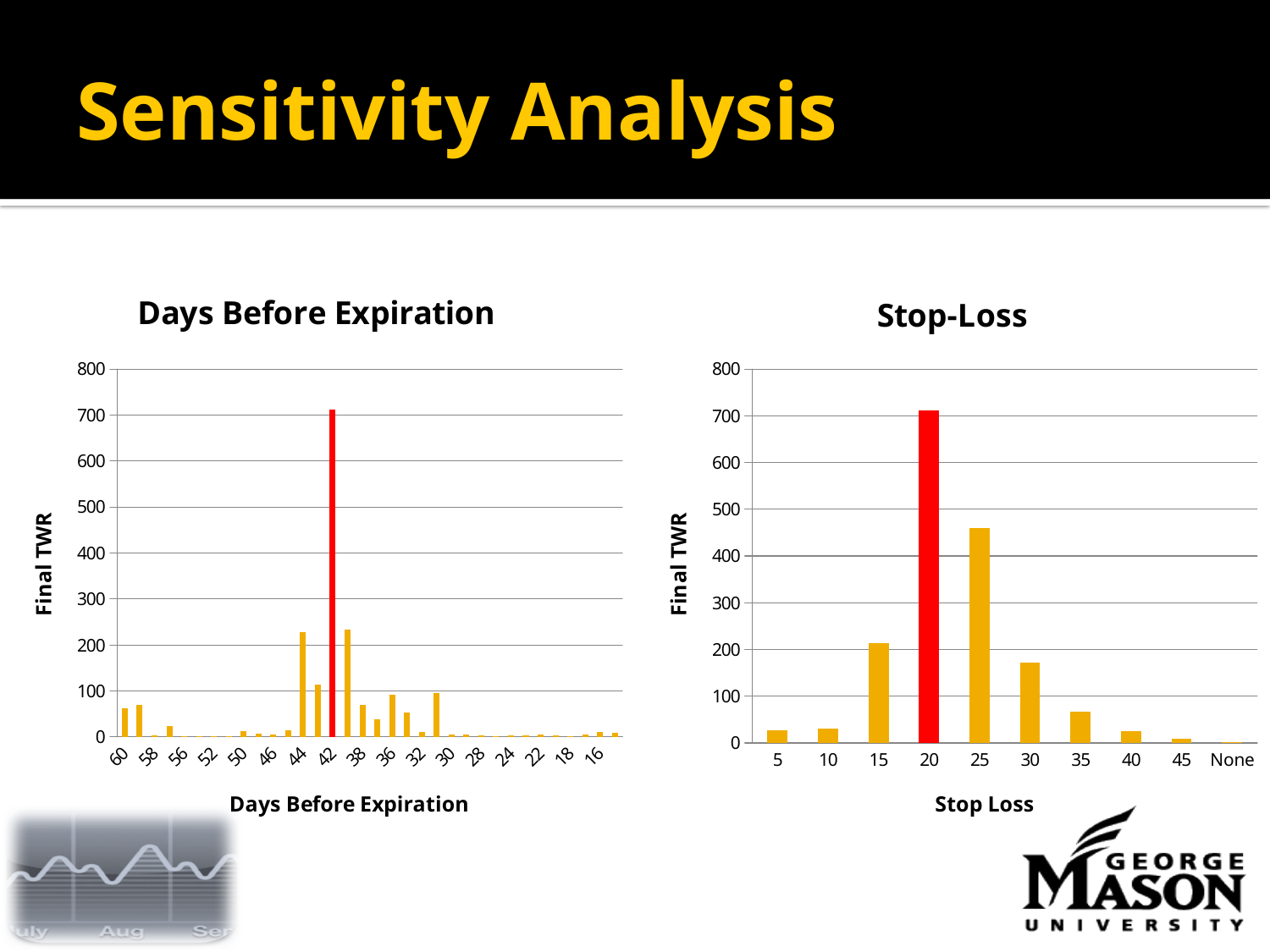
In the Stop-Loss chart, is the Final TWR for a stop loss of 25 greater or less than 500? less In the Stop-Loss chart, which has the larger Final TWR: a stop loss of 25 or a stop loss of 30? 25 In the Stop-Loss chart, is the Final TWR for a stop loss of 20 greater or less than 700? greater What is the y-axis label of the Stop-Loss chart? Final TWR In the Days Before Expiration chart, is the Final TWR at 42 days greater or less than 700? greater What kind of chart is the Stop-Loss chart? bar chart How many stop loss categories are shown on the x axis of the Stop-Loss chart? 10 In the Days Before Expiration chart, which number of days before expiration has the highest Final TWR? 42 In the Stop-Loss chart, which stop loss value has the highest Final TWR? 20 In the Days Before Expiration chart, what colour is the tallest bar? red